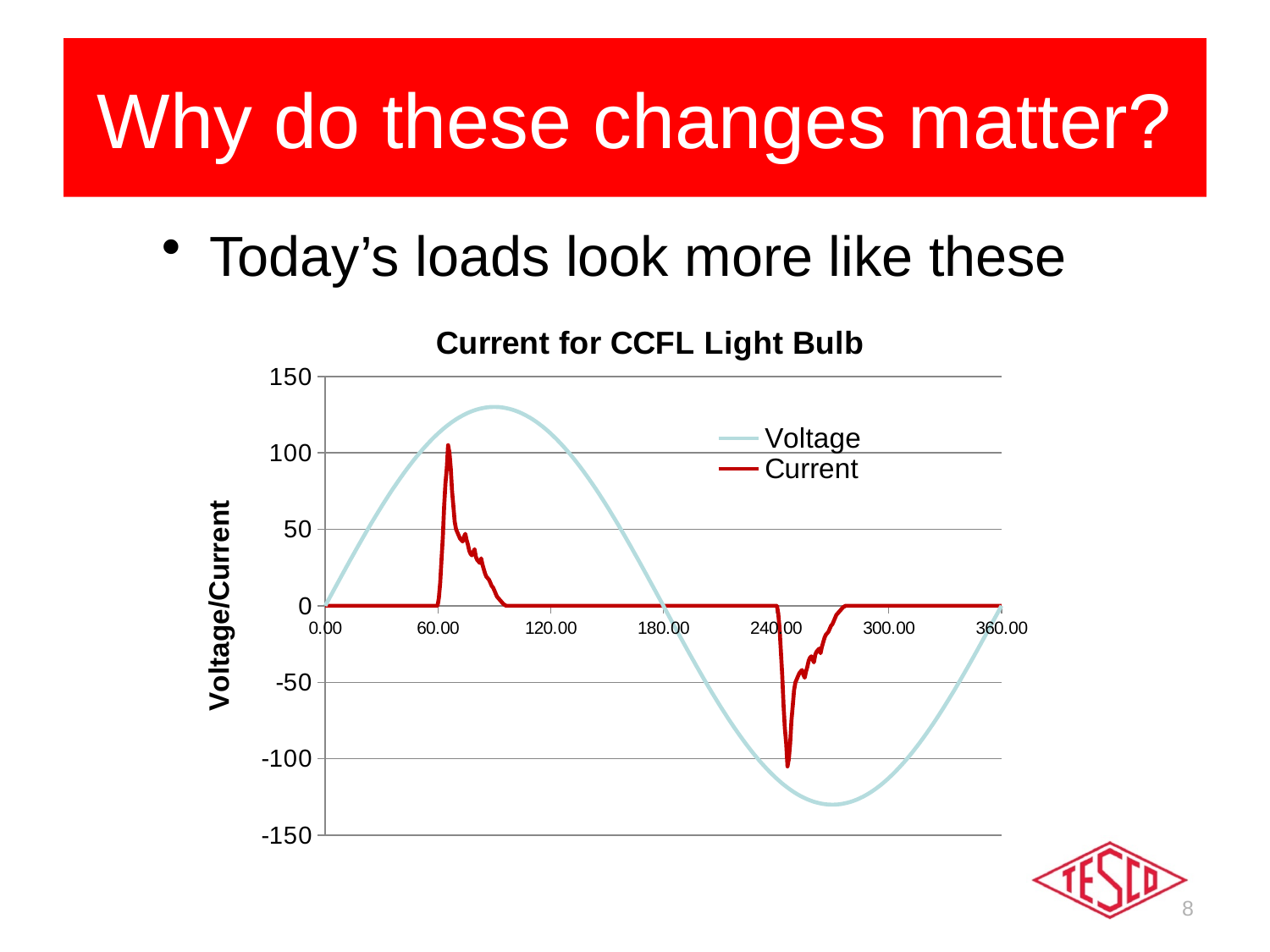
What kind of chart is shown on the slide? line chart Is the peak value of the Voltage series greater or less than 100? greater How many series does the chart's legend list? 2 What is the title of the chart? Current for CCFL Light Bulb Does the Voltage series rise or fall between 120.00 and 180.00 on the x axis? fall Is the minimum value of the Voltage series greater or less than -100? less Is the peak value of the Voltage series greater or less than 150? less What are the two series named in the chart's legend? Voltage and Current Does the Voltage series rise or fall between 0.00 and 60.00 on the x axis? rise Which series reaches the higher peak value, Voltage or Current? Voltage